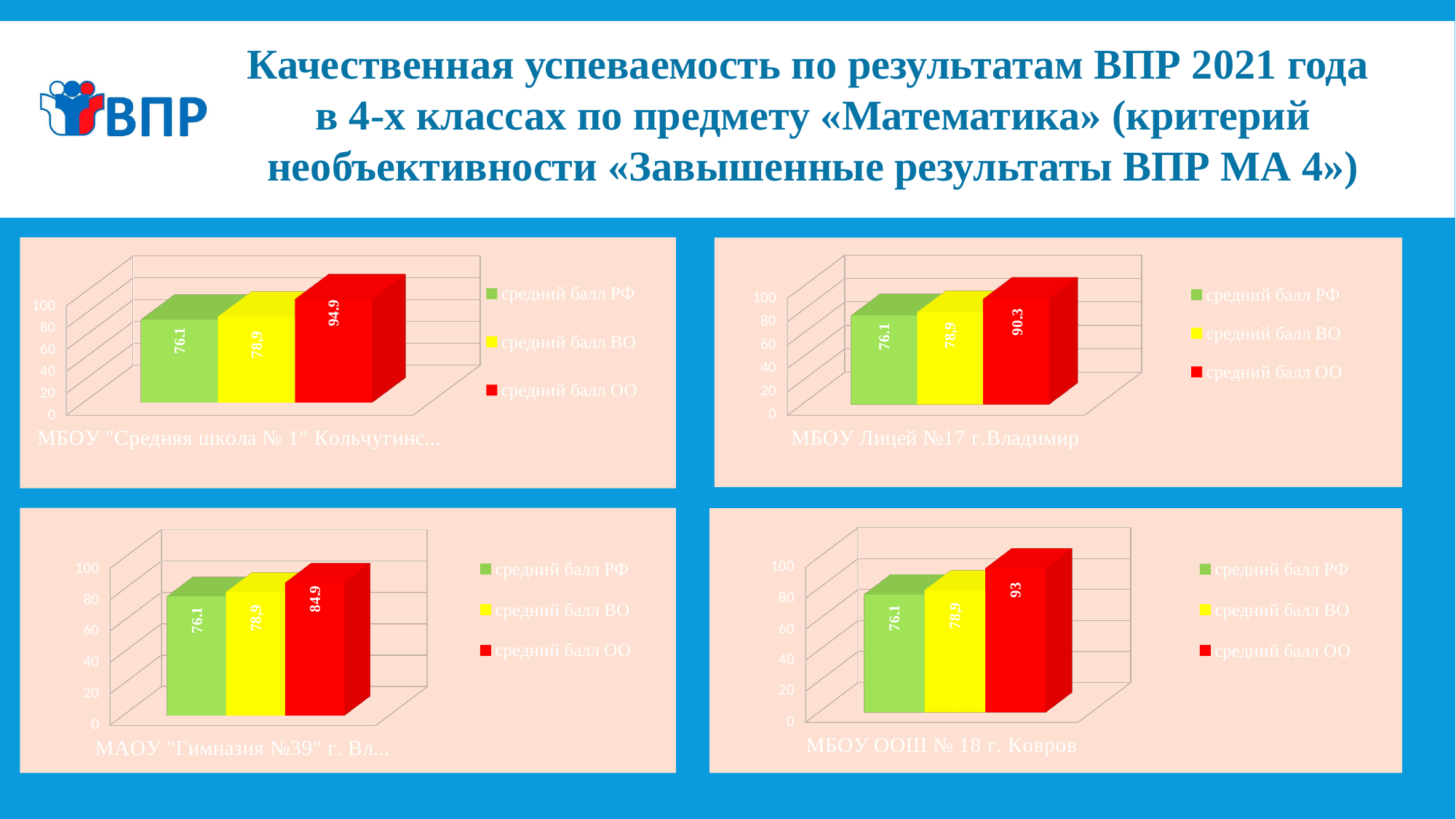
In the top-right chart (МБОУ Лицей №17 г.Владимир), what is the value for средний балл ОО? 90.3 What kind of chart is the top-right chart? bar chart In the top-left chart, what is the value for средний балл РФ? 76.1 In the bottom-left chart, what colour is the bar for средний балл ВО? yellow In the bottom-left chart (МАОУ "Гимназия №39" г. Вл...), what is the value for средний балл ОО? 84.9 In the bottom-left chart, what is the difference between средний балл ОО and средний балл РФ? 8.8 In the top-left chart (МБОУ "Средняя школа № 1" Кольчугинс...), what is the value for средний балл ОО? 94.9 In the bottom-right chart (МБОУ ООШ № 18 г. Ковров), what is the value for средний балл ОО? 93 In the bottom-right chart, which series has the highest value? средний балл ОО In the top-right chart, which series has the lowest value? средний балл РФ How many series does the legend of the bottom-right chart list? 3 In the top-left chart, which is larger: средний балл ВО or средний балл ОО? средний балл ОО